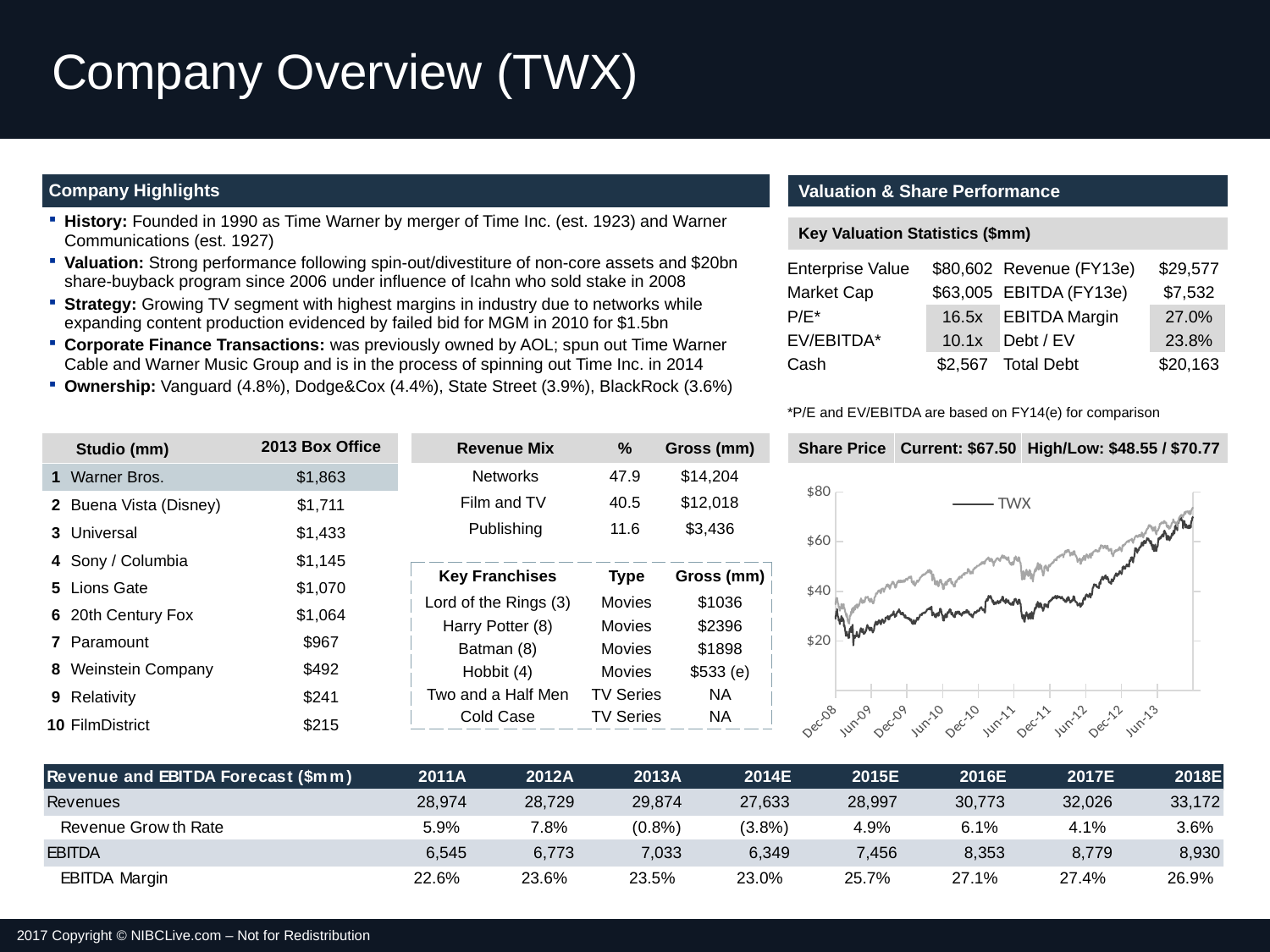
What is the highest value labelled on the y axis of the share price chart? $80 In the share price chart, is the TWX value higher at Dec-08 or at Jun-13? Jun-13 In the share price chart, is the TWX value at Jun-13 greater or less than $40? greater In the share price chart, what is the only series named in the legend? TWX How many series does the legend of the share price chart list? 1 In the share price chart, does the TWX line generally rise or fall from Dec-08 to Jun-13? rise In the share price chart, is the TWX value at Dec-10 greater or less than $40? less How many date labels are shown along the x axis of the share price chart? 10 What kind of chart is shown under the Share Price heading? line chart In the share price chart, is the TWX value at Dec-08 greater or less than $40? less What is the first date label on the x axis of the share price chart? Dec-08